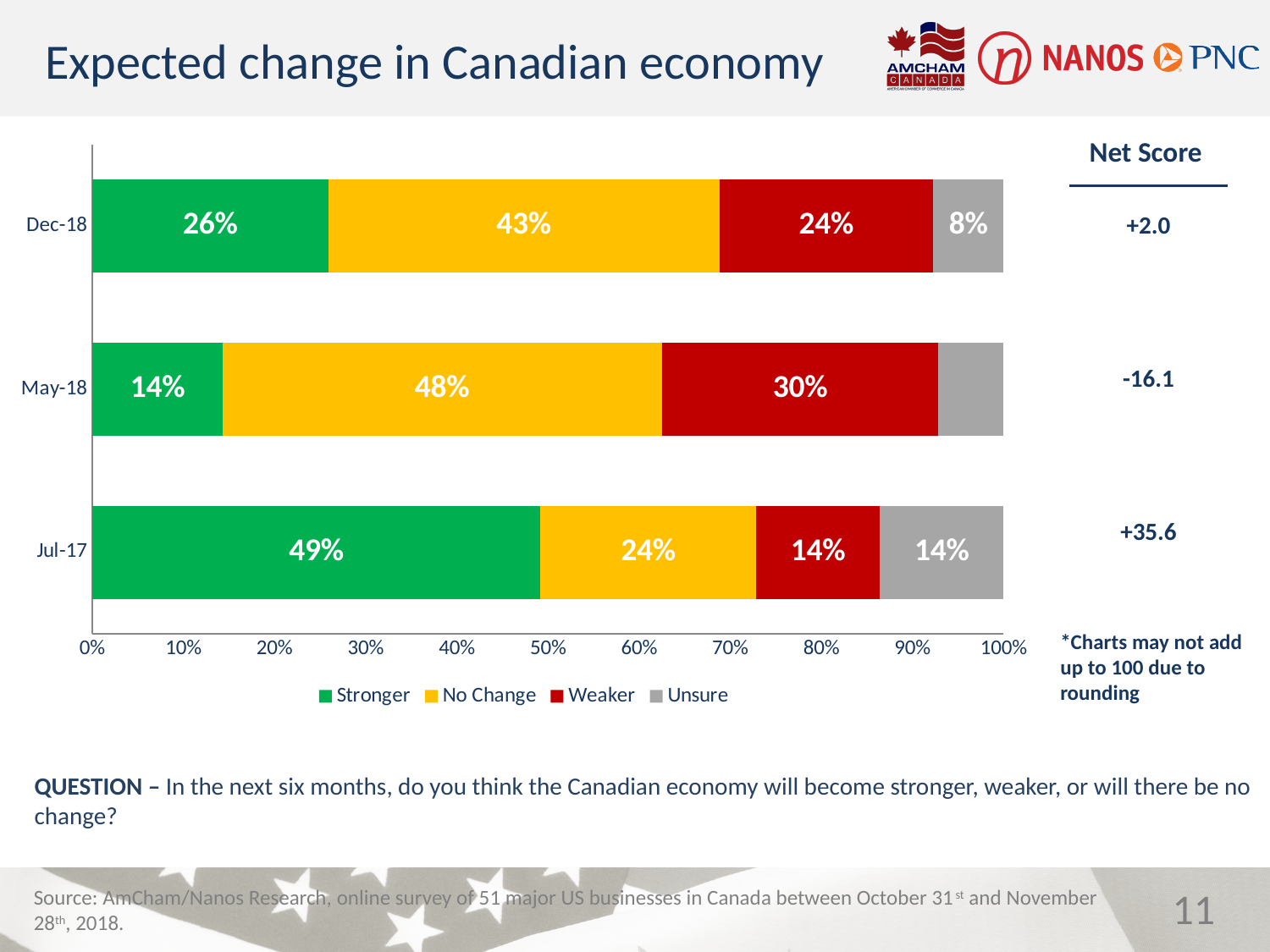
What is the Unsure value for Dec-18? 8% What percentage of respondents expected the Canadian economy to become stronger in Dec-18? 26% What is the No Change value for May-18? 48% What kind of chart is shown on the slide? Stacked bar chart Which period has the lowest Weaker value? Jul-17 How many series does the legend list? 4 Which period has the highest Stronger value? Jul-17 How many time periods are shown on the chart? 3 Which period has the larger No Change value, Dec-18 or Jul-17? Dec-18 How many percentage points higher is the Weaker value in May-18 than in Dec-18? 6 percentage points What is the Weaker value for Jul-17? 14% Is the Unsure value for May-18 greater or less than 10%? less